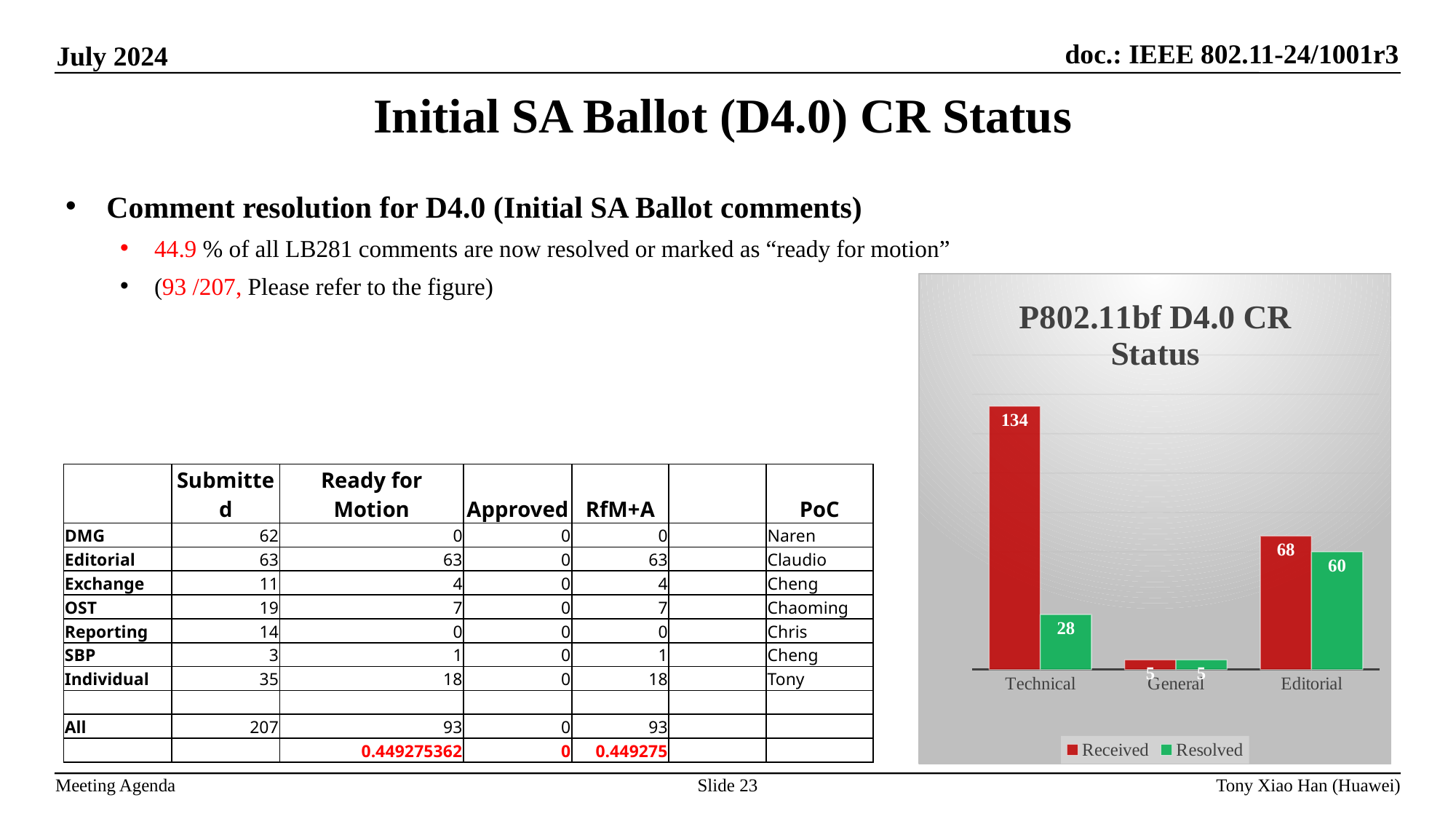
What is the difference between the Received and Resolved values for Technical? 106 Which is larger, the Resolved value for Editorial or the Resolved value for Technical? Editorial What is the title of the chart? P802.11bf D4.0 CR Status How many categories are shown on the x axis of the chart? 3 What is the Received value for Editorial? 68 Which category has the highest Received value? Technical How many series does the chart legend list? 2 What is the Received value for Technical? 134 What is the Resolved value for Editorial? 60 What is the Resolved value for Technical? 28 What kind of chart is shown on the slide? bar chart Which category has the lowest Resolved value? General